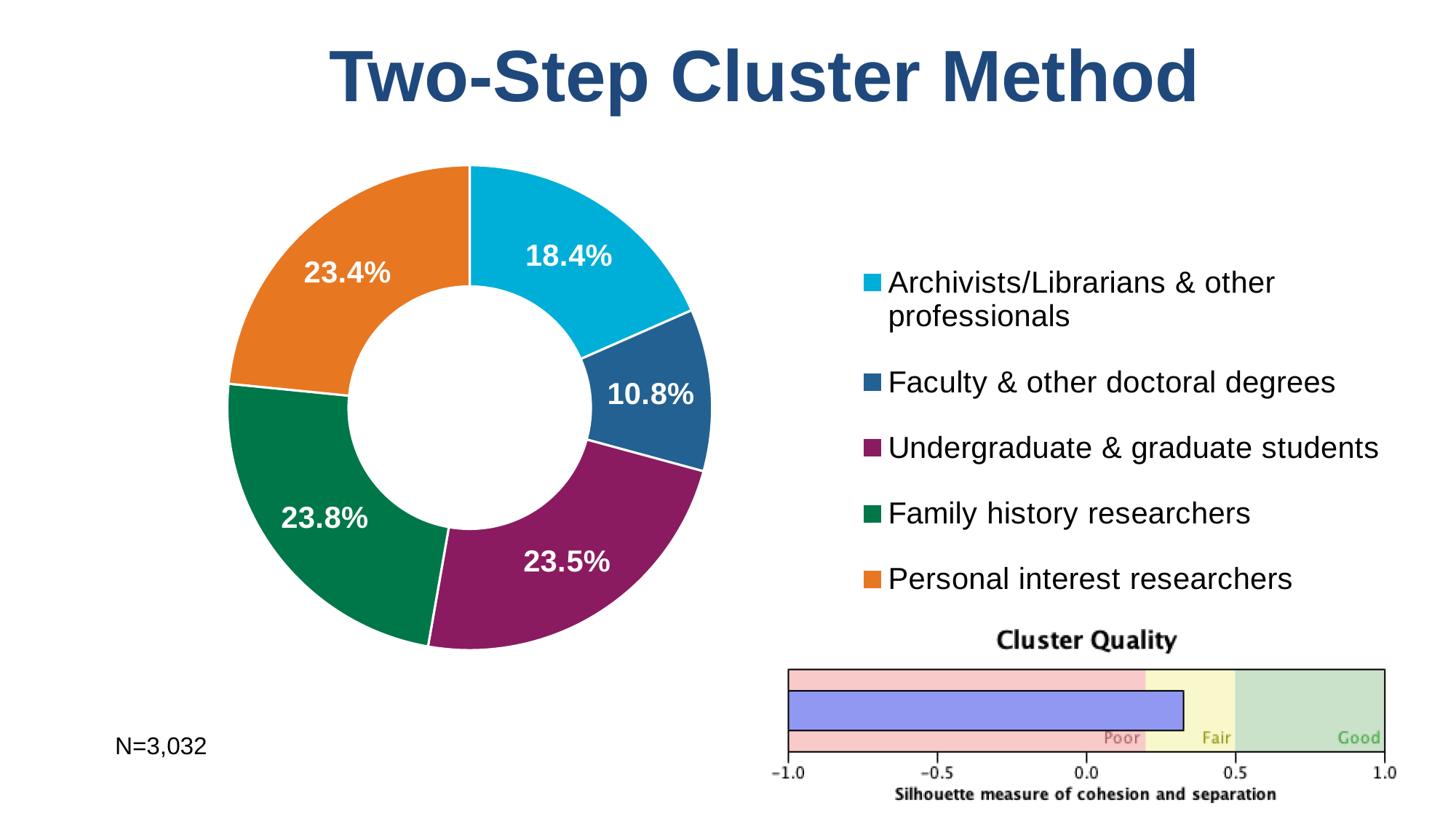
On the Cluster Quality chart, is the silhouette measure greater or less than 0.5? less On the donut chart, which is larger: Archivists/Librarians & other professionals or Faculty & other doctoral degrees? Archivists/Librarians & other professionals On the donut chart, what percentage is shown for Personal interest researchers? 23.4% On the donut chart, which category has the largest share? Family history researchers What type of chart is the chart on the left of the slide? Donut (pie) chart On the Cluster Quality chart, which quality band does the bar end in? Fair On the donut chart, what percentage is shown for Faculty & other doctoral degrees? 10.8% On the donut chart, what percentage is shown for Archivists/Librarians & other professionals? 18.4% On the donut chart, what percentage is shown for Family history researchers? 23.8% How many categories does the donut chart show? 5 On the donut chart, what is the difference in percentage points between Undergraduate & graduate students and Faculty & other doctoral degrees? 12.7 On the donut chart, which category has the smallest share? Faculty & other doctoral degrees